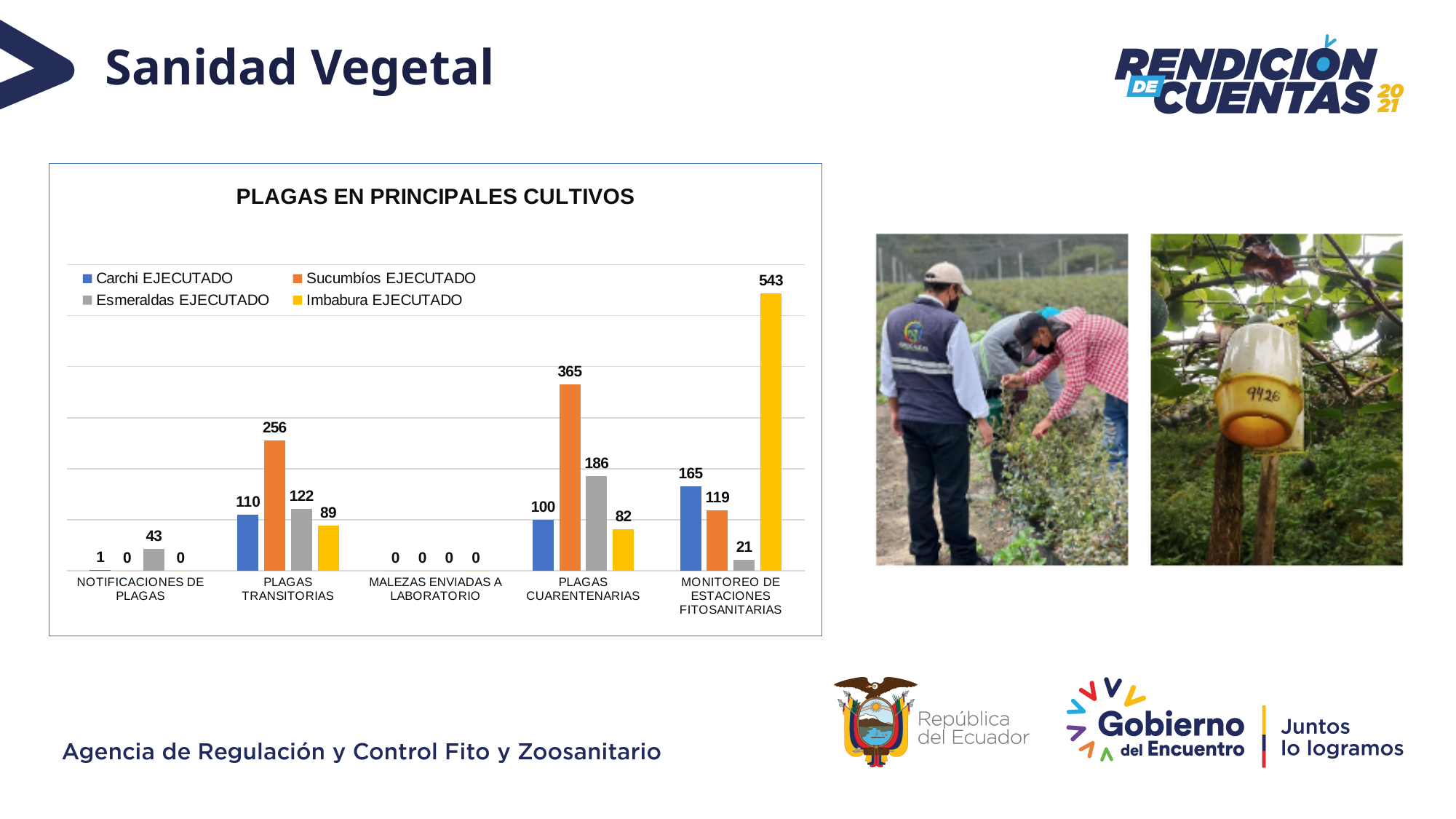
Which series has the highest value in the PLAGAS TRANSITORIAS category? Sucumbíos EJECUTADO Which series has the lowest value in the MONITOREO DE ESTACIONES FITOSANITARIAS category? Esmeraldas EJECUTADO How many categories are shown on the x axis of the chart? 5 How many series does the chart legend list? 4 What is the value for Imbabura EJECUTADO in the MONITOREO DE ESTACIONES FITOSANITARIAS category? 543 What type of chart is shown on the slide? Bar chart What is the title of the chart? PLAGAS EN PRINCIPALES CULTIVOS What is the difference between the Sucumbíos EJECUTADO and Carchi EJECUTADO values in the PLAGAS CUARENTENARIAS category? 265 In the PLAGAS TRANSITORIAS category, which is larger: Carchi EJECUTADO or Esmeraldas EJECUTADO? Esmeraldas EJECUTADO What is the value for Sucumbíos EJECUTADO in the PLAGAS CUARENTENARIAS category? 365 What is the value for all four series in the MALEZAS ENVIADAS A LABORATORIO category? 0 What is the value for Esmeraldas EJECUTADO in the NOTIFICACIONES DE PLAGAS category? 43